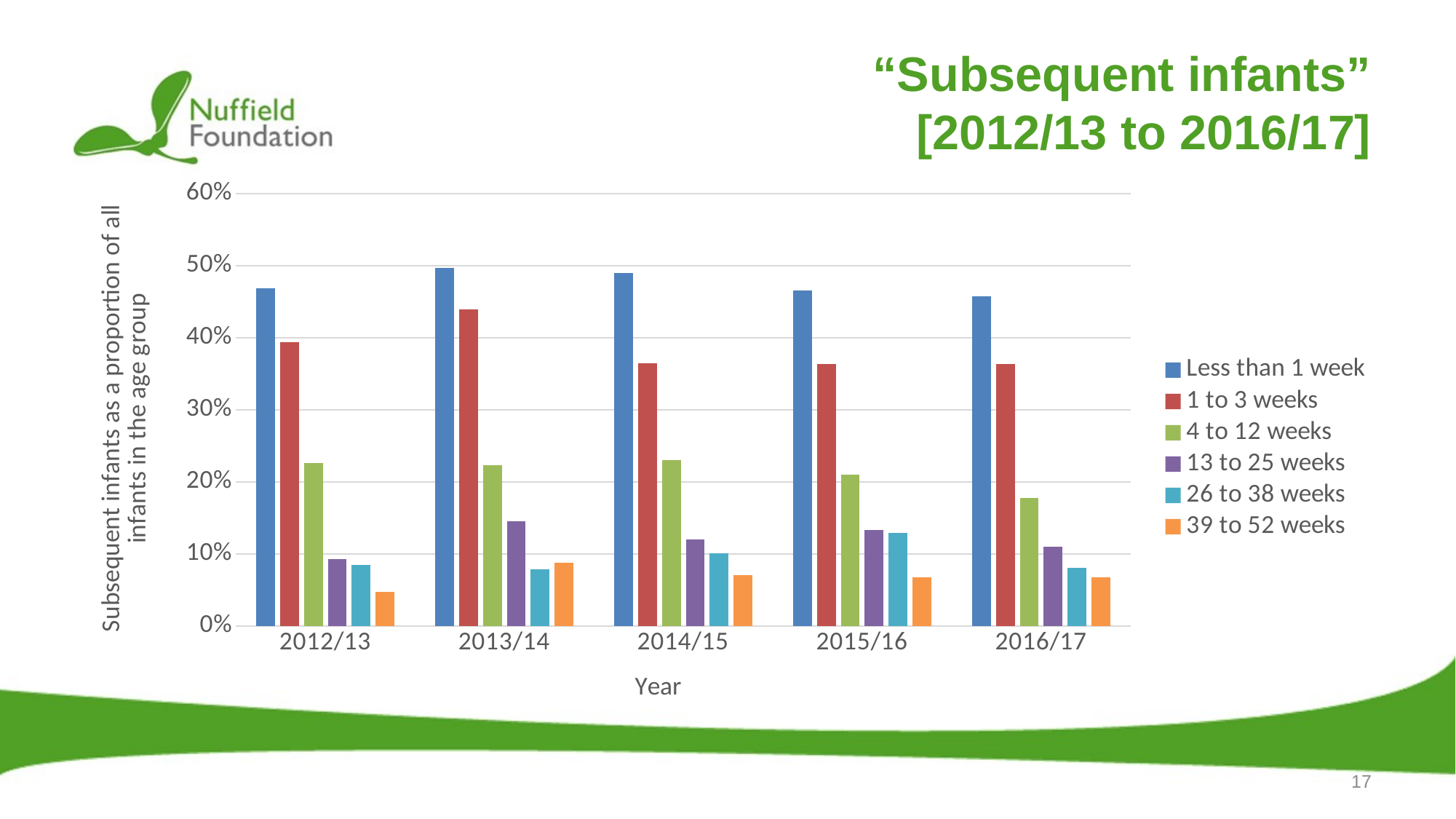
What kind of chart is shown on the slide? bar chart Which age group has the lowest proportion of subsequent infants in 2012/13? 39 to 52 weeks Is the value for '1 to 3 weeks' in 2013/14 greater or less than 40%? greater Is the value for '4 to 12 weeks' in 2016/17 greater or less than 20%? less Which age group has the highest proportion of subsequent infants in every year shown? Less than 1 week Does the value for 'Less than 1 week' rise or fall from 2013/14 to 2016/17? fall Is the value for 'Less than 1 week' in 2012/13 greater or less than 40%? greater In which year is the value for '1 to 3 weeks' highest? 2013/14 How many series does the legend list? 6 Which is larger: the value for '13 to 25 weeks' in 2012/13 or in 2013/14? 2013/14 In which year is the value for '39 to 52 weeks' lowest? 2012/13 How many years are shown on the x axis? 5